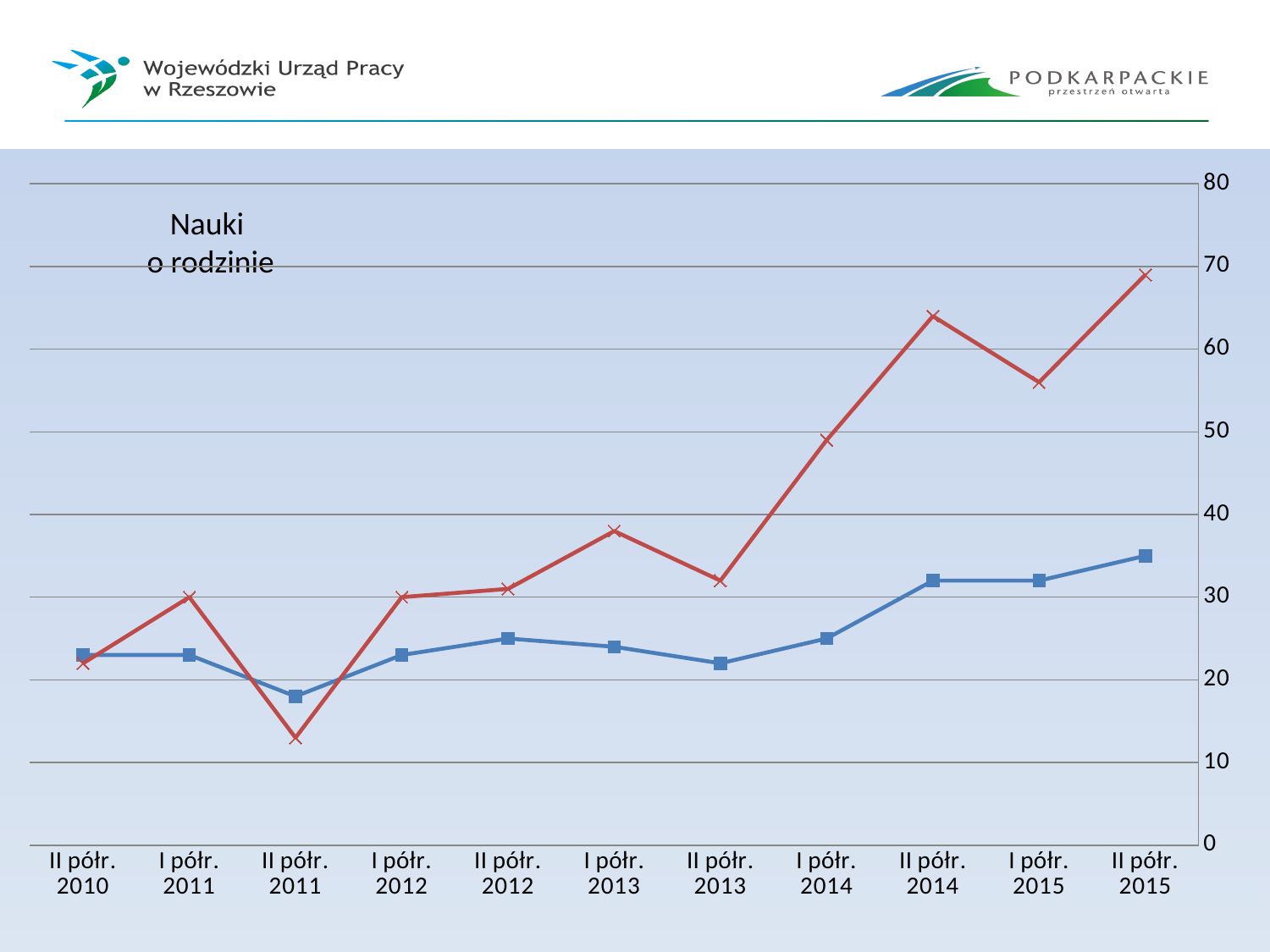
How many lines are plotted on the chart? 2 In which period does the red line reach its highest value? II półr. 2015 What is the title of the chart? Nauki o rodzinie Is the value of the red line for II półr. 2011 greater or less than 20? less In which period does the red line reach its lowest value? II półr. 2011 What kind of chart is shown on the slide? line chart In which period does the blue line reach its highest value? II półr. 2015 Which line has the higher value in II półr. 2015, the red line or the blue line? the red line Is the value of the blue line for I półr. 2012 greater or less than 30? less In which period does the blue line reach its lowest value? II półr. 2011 Is the value of the red line for II półr. 2015 greater or less than 60? greater How many periods are shown on the x axis of the chart? 11